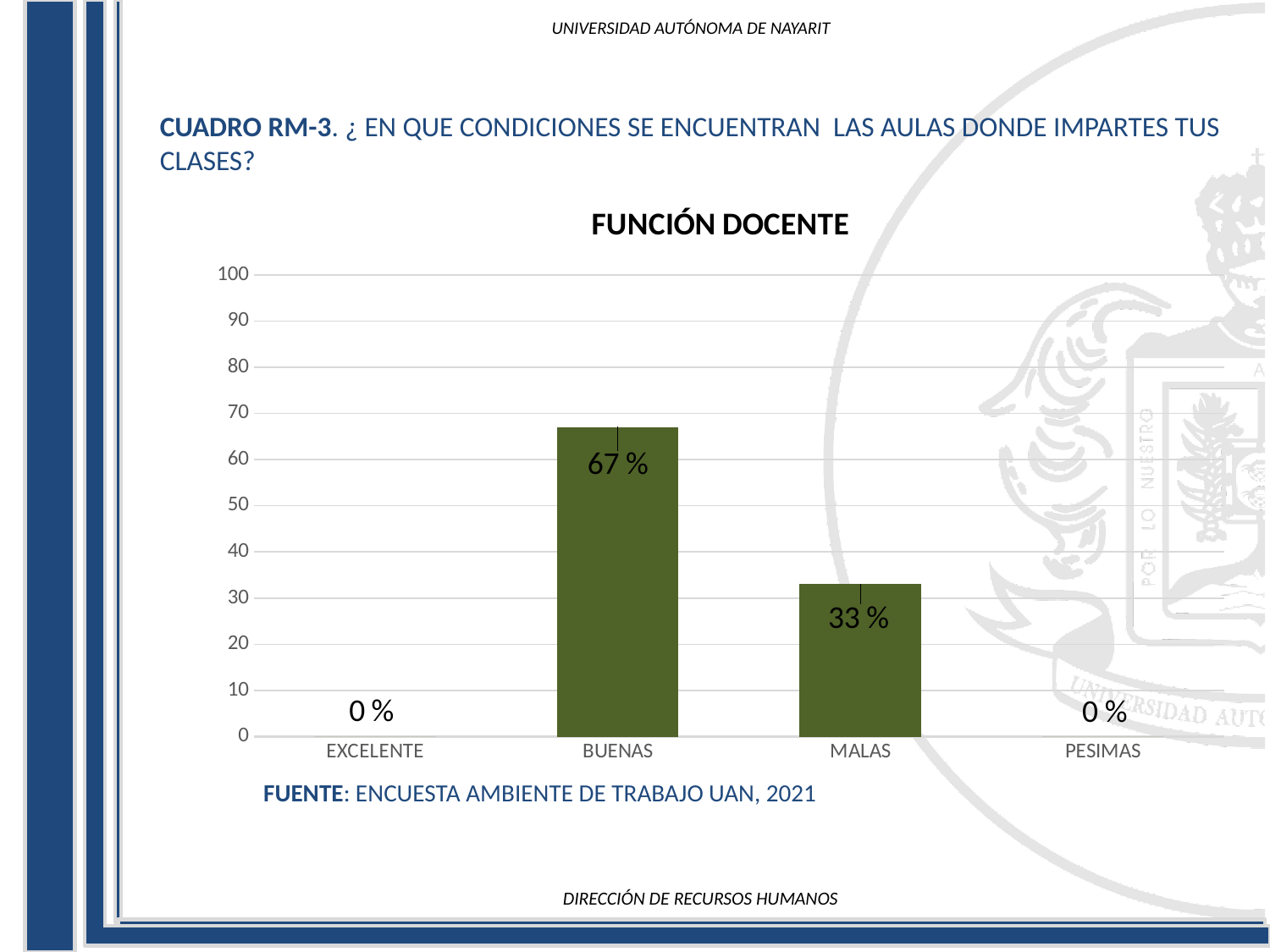
How many categories are shown on the x axis? 4 Which category has the highest value? BUENAS Which is larger, the value for BUENAS or the value for MALAS? BUENAS Is the value for MALAS greater or less than 40? less What is the value for EXCELENTE? 0 % What is the value for PESIMAS? 0 % What is the value for MALAS? 33 % What kind of chart is shown on the slide? bar chart Is the value for BUENAS greater or less than 60? greater What is the title of the chart? FUNCIÓN DOCENTE What is the value for BUENAS? 67 % What is the difference between the values for BUENAS and MALAS? 34 %